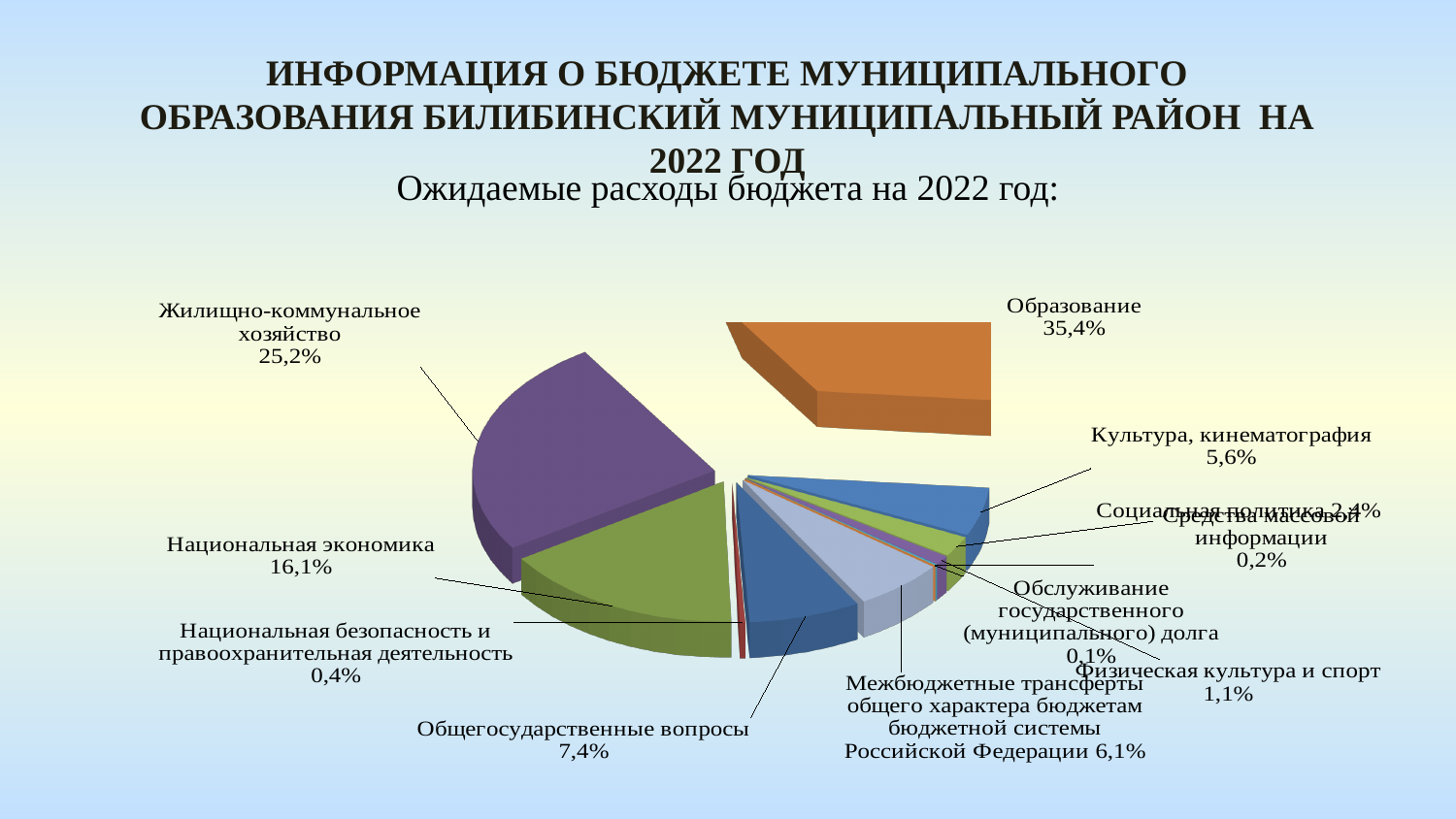
How many categories (slices) does the pie chart show? 11 What percentage is shown for Национальная экономика? 16,1% Which category has the largest share of the pie? Образование What percentage is shown for Культура, кинематография? 5,6% What share of expected 2022 budget expenditures goes to Образование? 35,4% What type of chart is shown on the slide? Pie chart What percentage is shown for Жилищно-коммунальное хозяйство? 25,2% Which category has the smallest share of the pie? Обслуживание государственного (муниципального) долга What is the subtitle of the chart on the slide? Ожидаемые расходы бюджета на 2022 год: What is the difference in percentage points between Образование and Жилищно-коммунальное хозяйство? 10,2 What percentage is shown for Общегосударственные вопросы? 7,4% Which is larger: the share for Общегосударственные вопросы or the share for Межбюджетные трансферты общего характера бюджетам бюджетной системы Российской Федерации? Общегосударственные вопросы